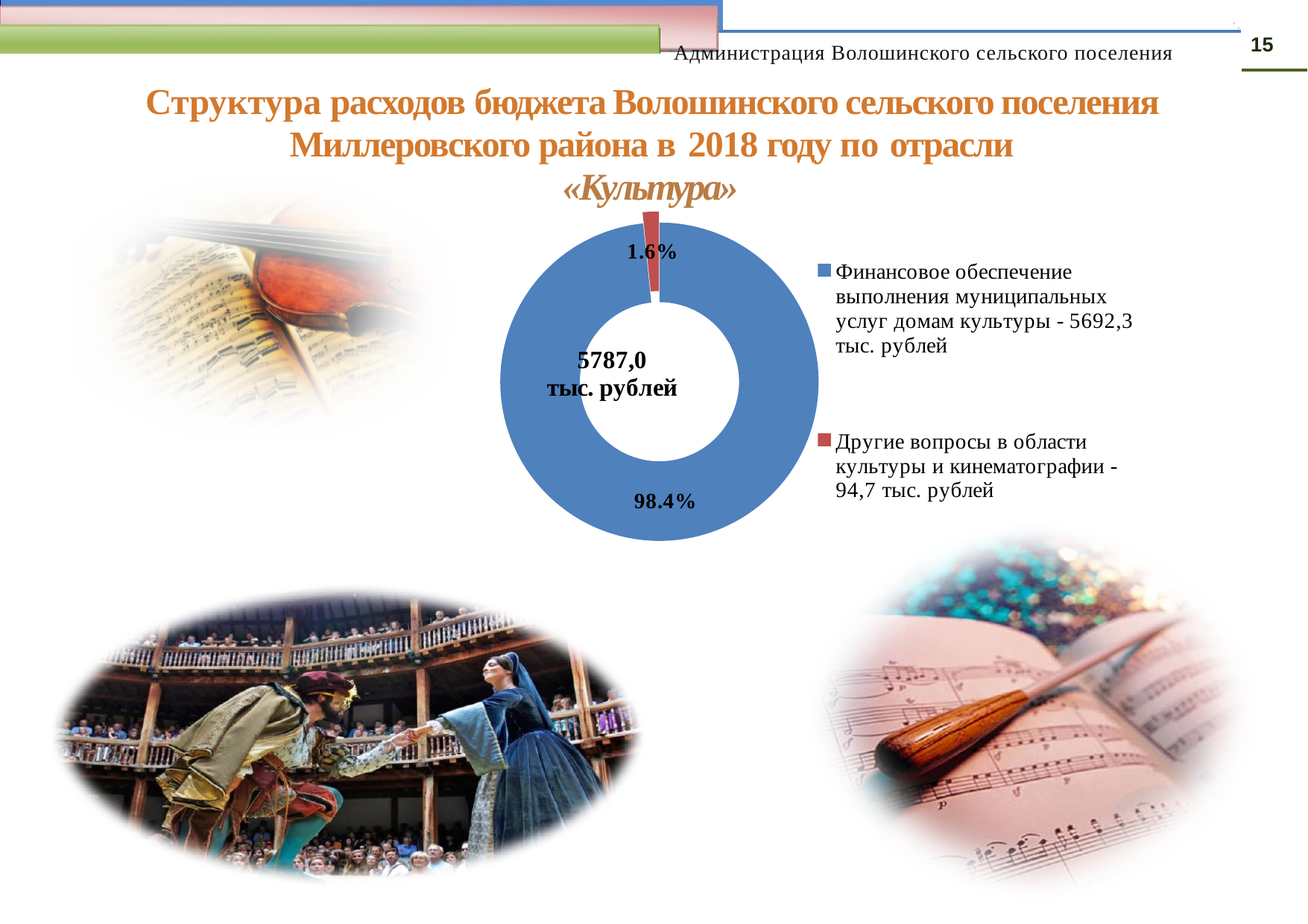
What total is shown in the centre of the doughnut chart? 5787,0 тыс. рублей What value in тыс. рублей does the legend give for "Другие вопросы в области культуры и кинематографии"? 94,7 тыс. рублей How many slices does the doughnut chart have? 2 Which category has the largest share of the chart? Финансовое обеспечение выполнения муниципальных услуг домам культуры What value in тыс. рублей does the legend give for "Финансовое обеспечение выполнения муниципальных услуг домам культуры"? 5692,3 тыс. рублей What colour is the slice for "Другие вопросы в области культуры и кинематографии"? Red How many entries does the legend list? 2 What share of the chart is labelled for "Финансовое обеспечение выполнения муниципальных услуг домам культуры"? 98.4% Which category has the smallest share of the chart? Другие вопросы в области культуры и кинематографии What kind of chart is shown on the slide? Doughnut (pie) chart What share of the chart is labelled for "Другие вопросы в области культуры и кинематографии"? 1.6% What is the difference in percentage points between the two slices of the chart? 96.8 percentage points